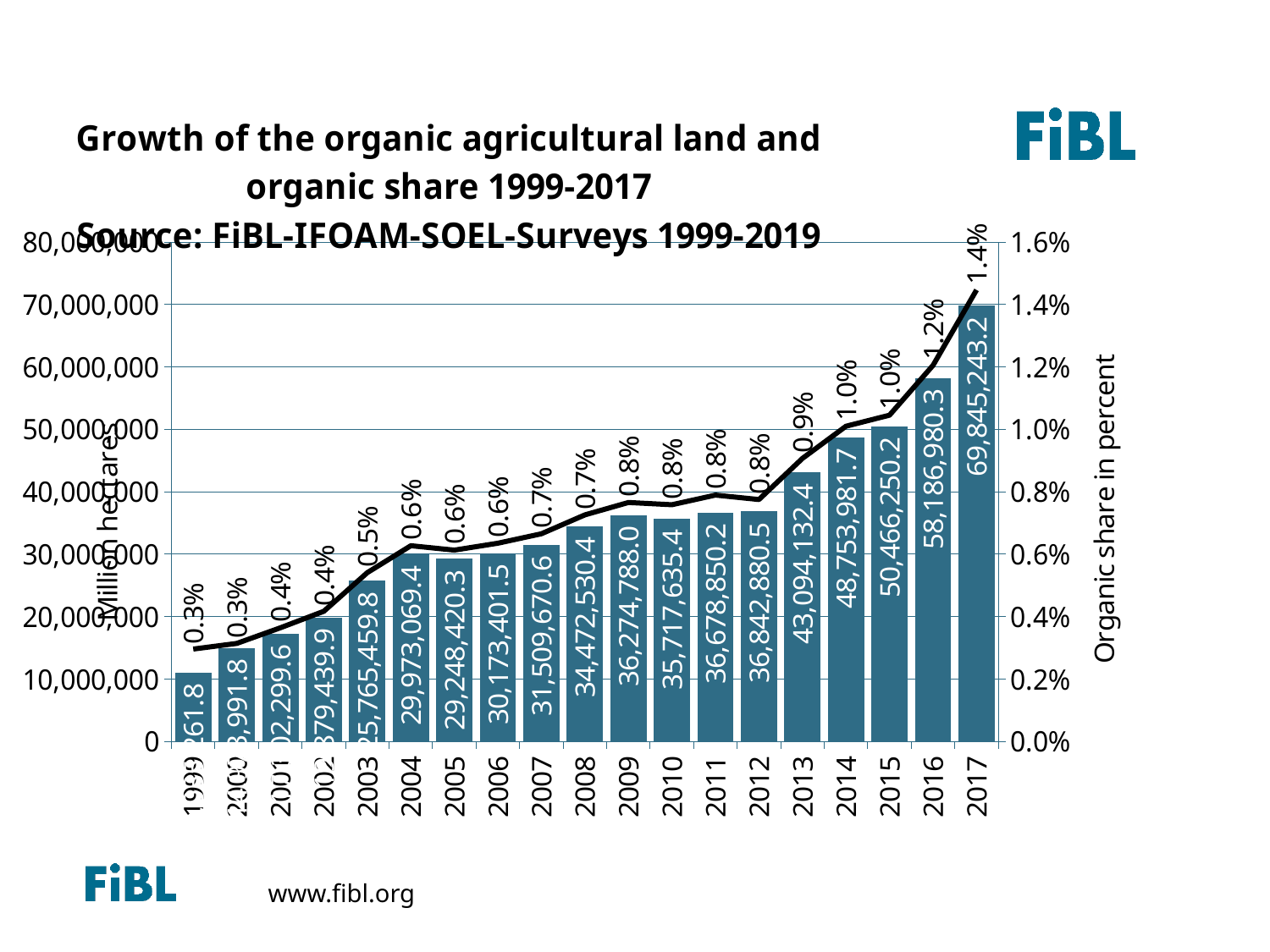
Which year has the highest organic agricultural land bar? 2017 Is the organic agricultural land bar for 2001 greater or less than 20,000,000? less What organic share in percent is shown for 2017? 1.4% What organic share in percent is shown for 2003? 0.5% What is the title of the right-hand vertical axis? Organic share in percent Which year has the lowest organic agricultural land bar? 1999 Which year has the larger organic agricultural land value, 2009 or 2010? 2009 How many years are shown on the x axis? 19 What kind of chart is this? Combination bar and line chart What is the organic agricultural land value shown for 2013? 43,094,132.4 What is the organic agricultural land value shown for 2017? 69,845,243.2 What is the difference between the organic agricultural land values for 2017 and 2016? 11,658,262.9